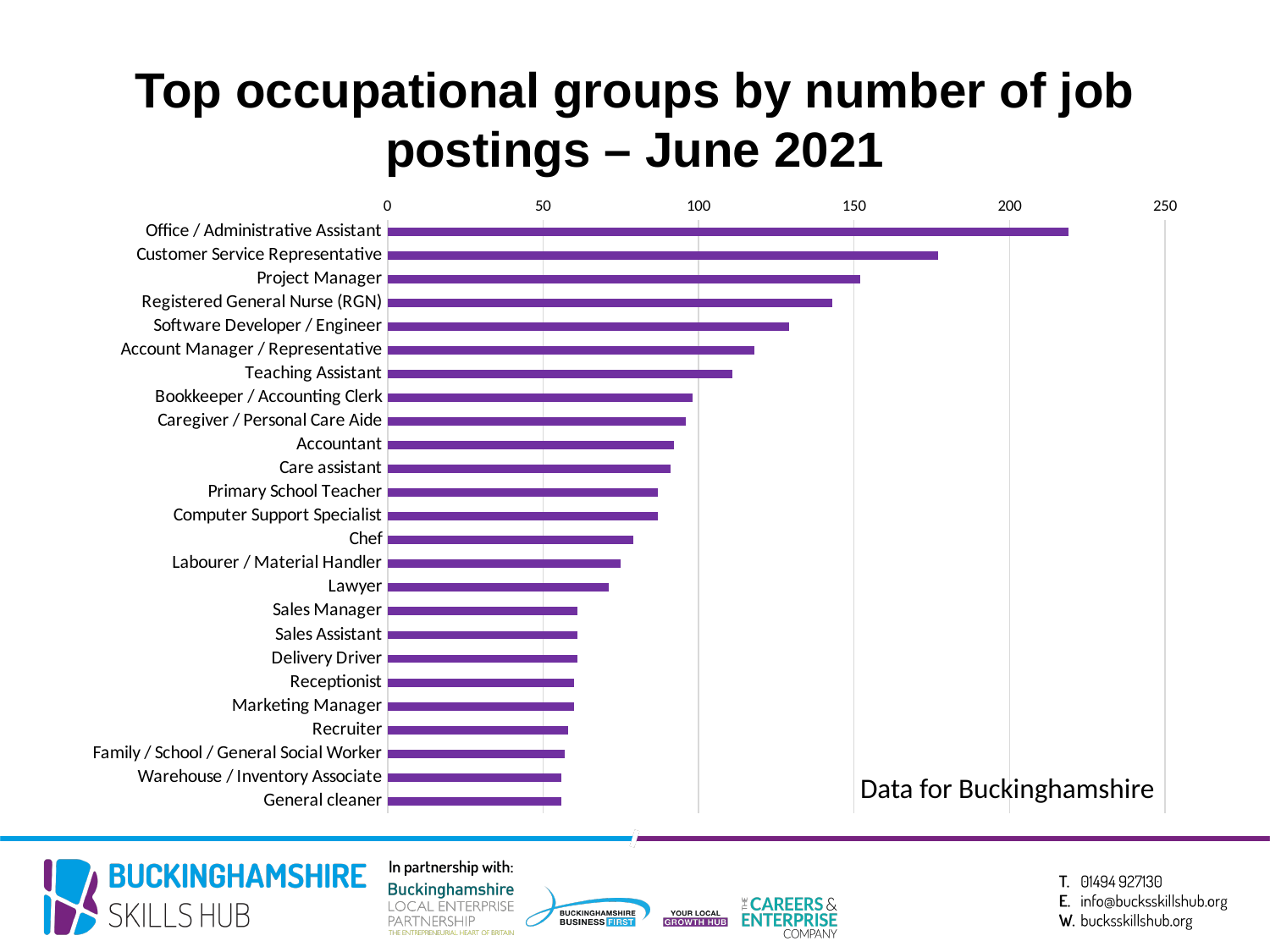
Do the bars get longer or shorter going from the top of the chart to the bottom? shorter Is the value for Software Developer / Engineer greater or less than 100? greater Which area does the chart state the data is for? Buckinghamshire How many occupational groups are plotted in the chart? 25 Is the value for Lawyer greater or less than 50? greater Which has more job postings, Teaching Assistant or Accountant? Teaching Assistant Which has more job postings, Chef or Lawyer? Chef Is the value for Chef greater or less than 100? less Which occupational group has the highest number of job postings? Office / Administrative Assistant What kind of chart is shown on the slide? Bar chart